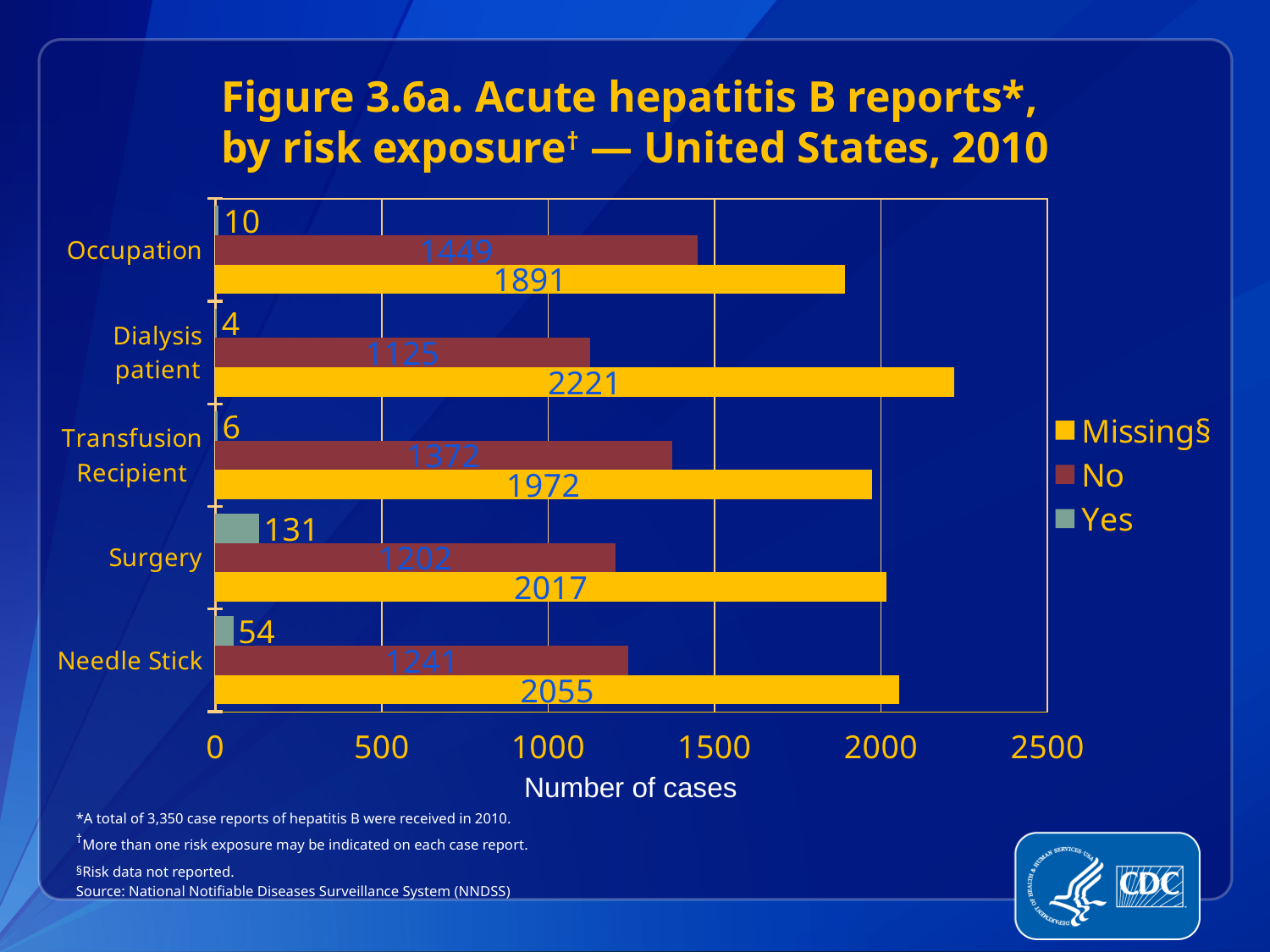
Which is larger: the 'No' value for Occupation or the 'No' value for Surgery? Occupation What is the label of the x axis? Number of cases Which category has the highest 'Missing' value? Dialysis patient What kind of chart is shown on the slide? Bar chart What is the number of cases for 'Yes' in the Surgery category? 131 Which category has the lowest 'Yes' value? Dialysis patient Is the 'Missing' value for Occupation greater or less than 2000? less How many risk exposure categories are shown on the chart? 5 What is the number of cases for 'No' in the Transfusion Recipient category? 1372 How many series does the legend list? 3 What is the difference between the 'Missing' and 'No' values for Needle Stick? 814 What is the number of cases for 'Missing' in the Dialysis patient category? 2221